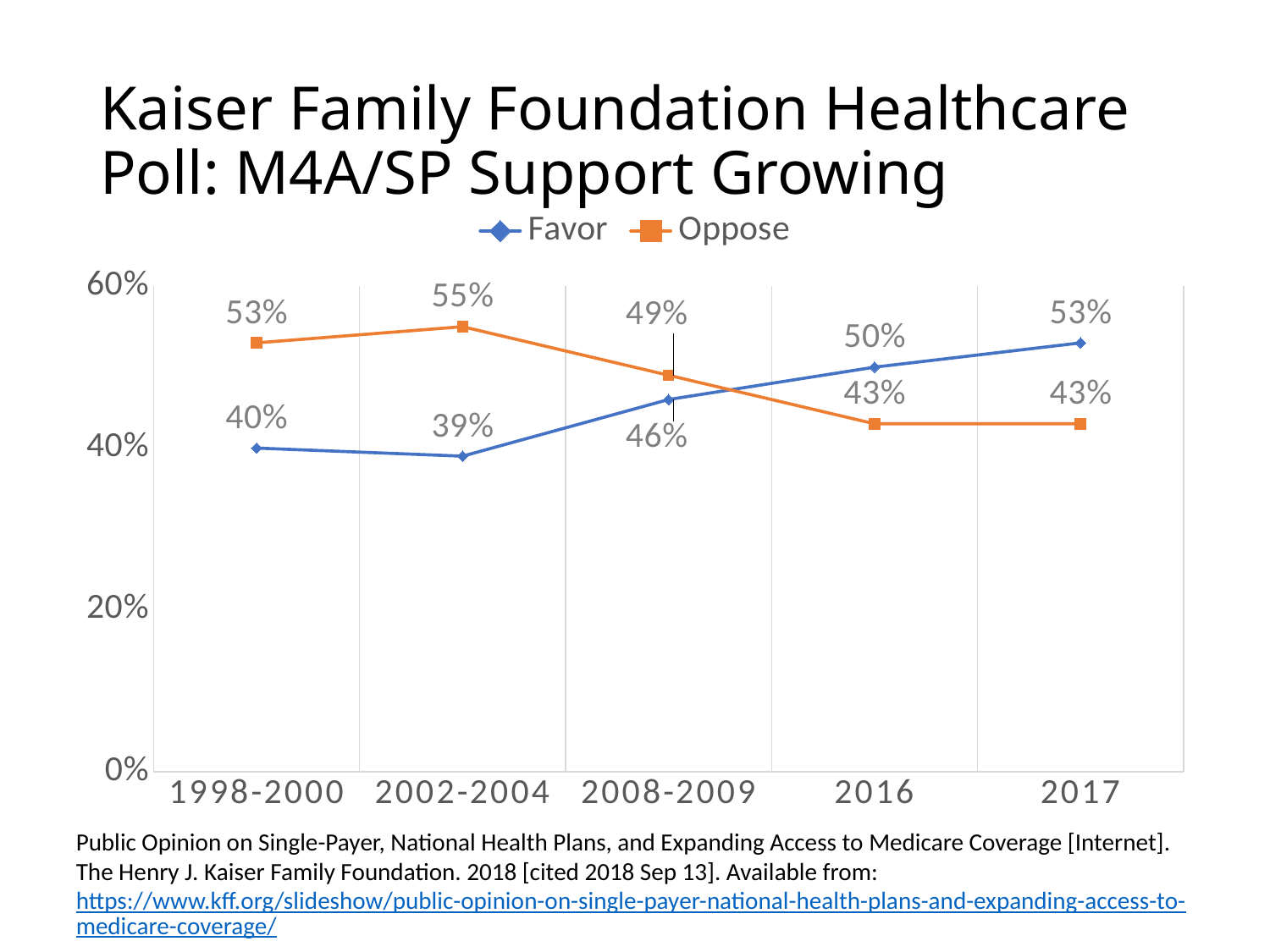
In 2016, which is larger, Favor or Oppose? Favor How many series does the legend list? 2 What is the difference between the Oppose and Favor values in 1998-2000? 13% Does the Favor series generally rise or fall from 2002-2004 to 2017? rise Which series is drawn in orange? Oppose What kind of chart is shown on the slide? line chart What is the Favor value for 1998-2000? 40% How many time periods are shown on the x axis? 5 In which period is the Oppose value highest? 2002-2004 In which period is the Favor value lowest? 2002-2004 What is the Oppose value for 2002-2004? 55% What is the Favor value for 2017? 53%